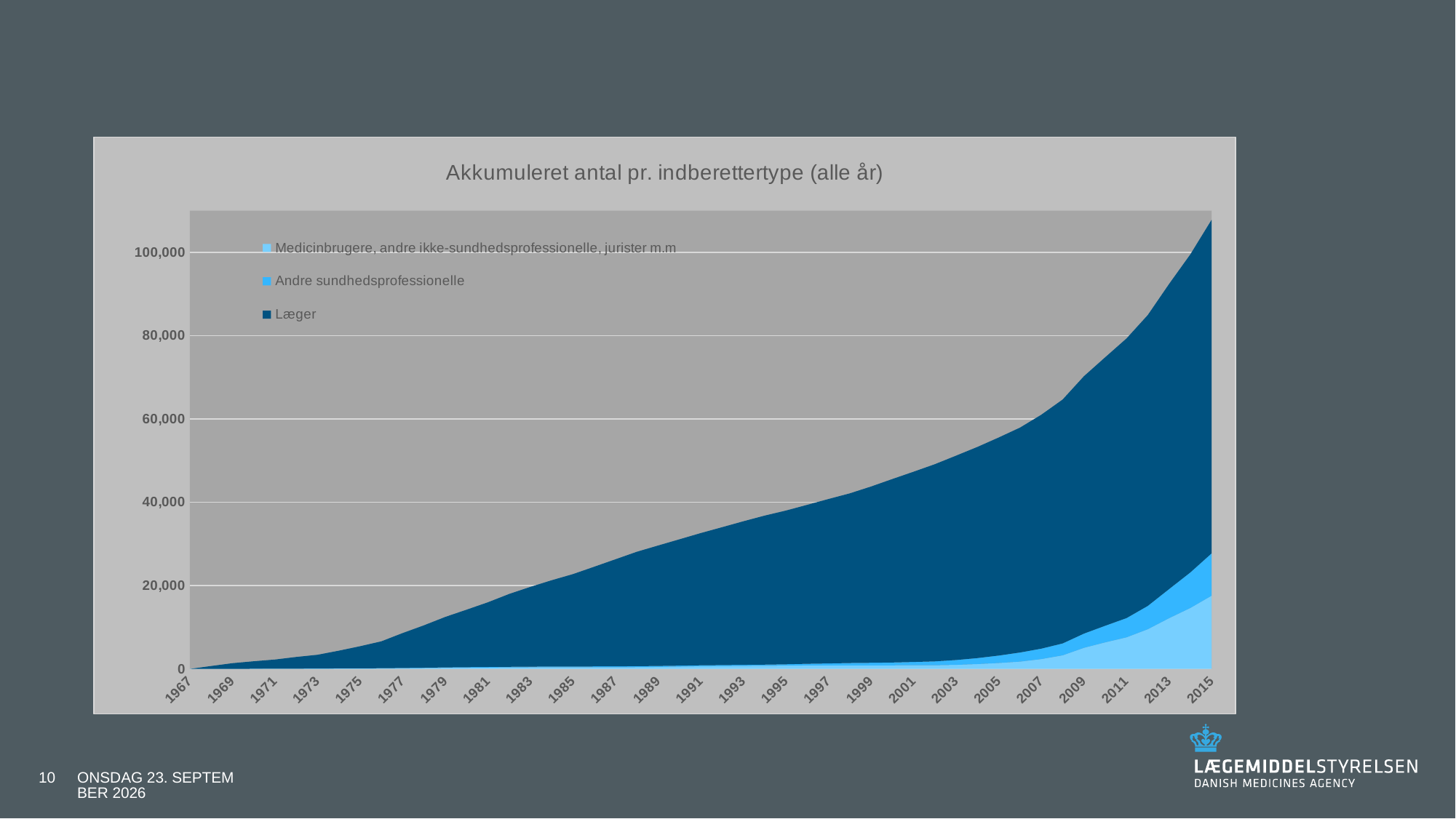
What kind of chart is shown on the slide? Stacked area chart How many series does the legend list? 3 Is the total accumulated value in 2015 greater or less than 100,000? greater What is the title of the chart? Akkumuleret antal pr. indberettertype (alle år) Is the total accumulated value in 2001 greater or less than 40,000? greater How many year labels are shown on the x axis? 25 Does the total accumulated number rise or fall from 1967 to 2015? Rise Which series accounts for the largest share of the accumulated total in 2015? Læger Which series accounts for the smallest share of the accumulated total in 2015? Andre sundhedsprofessionelle Which series is shown in the darkest blue colour? Læger Is the total accumulated value in 2009 greater or less than 80,000? less